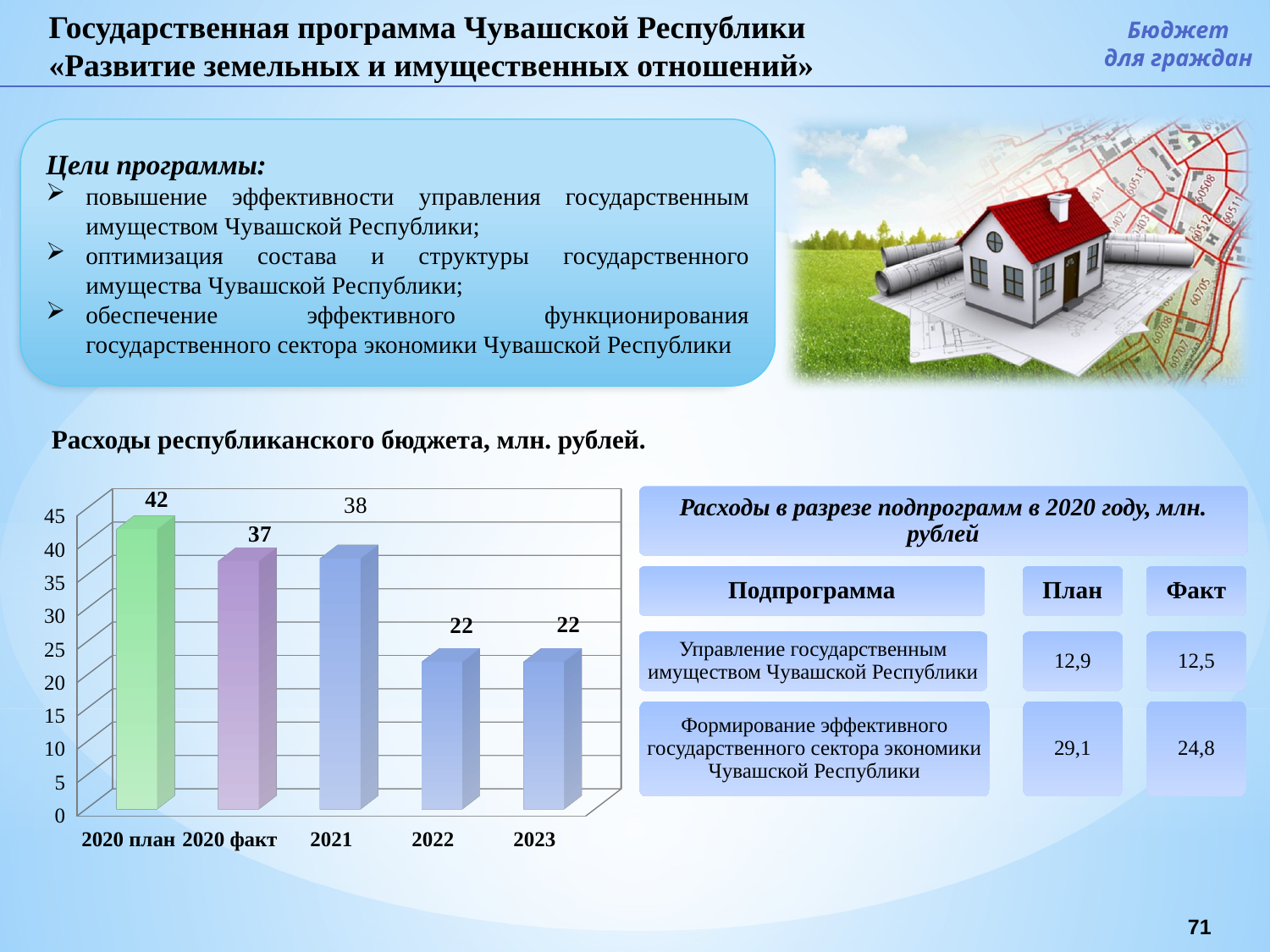
What is the difference between the values for 2020 план and 2020 факт? 5 What is the difference between the values for 2021 and 2022? 16 What kind of chart is shown on the slide? bar chart Is the value for 2022 greater or less than 30? less What is the value for 2021 in the chart? 38 Which category has the highest value in the chart? 2020 план What is the value for 2023 in the chart? 22 What is the value for 2020 факт in the chart? 37 What is the value for 2020 план in the chart? 42 How many categories are shown on the x axis of the chart? 5 What is the title above the chart? Расходы республиканского бюджета, млн. рублей. Which is larger, the value for 2020 факт or the value for 2022? 2020 факт